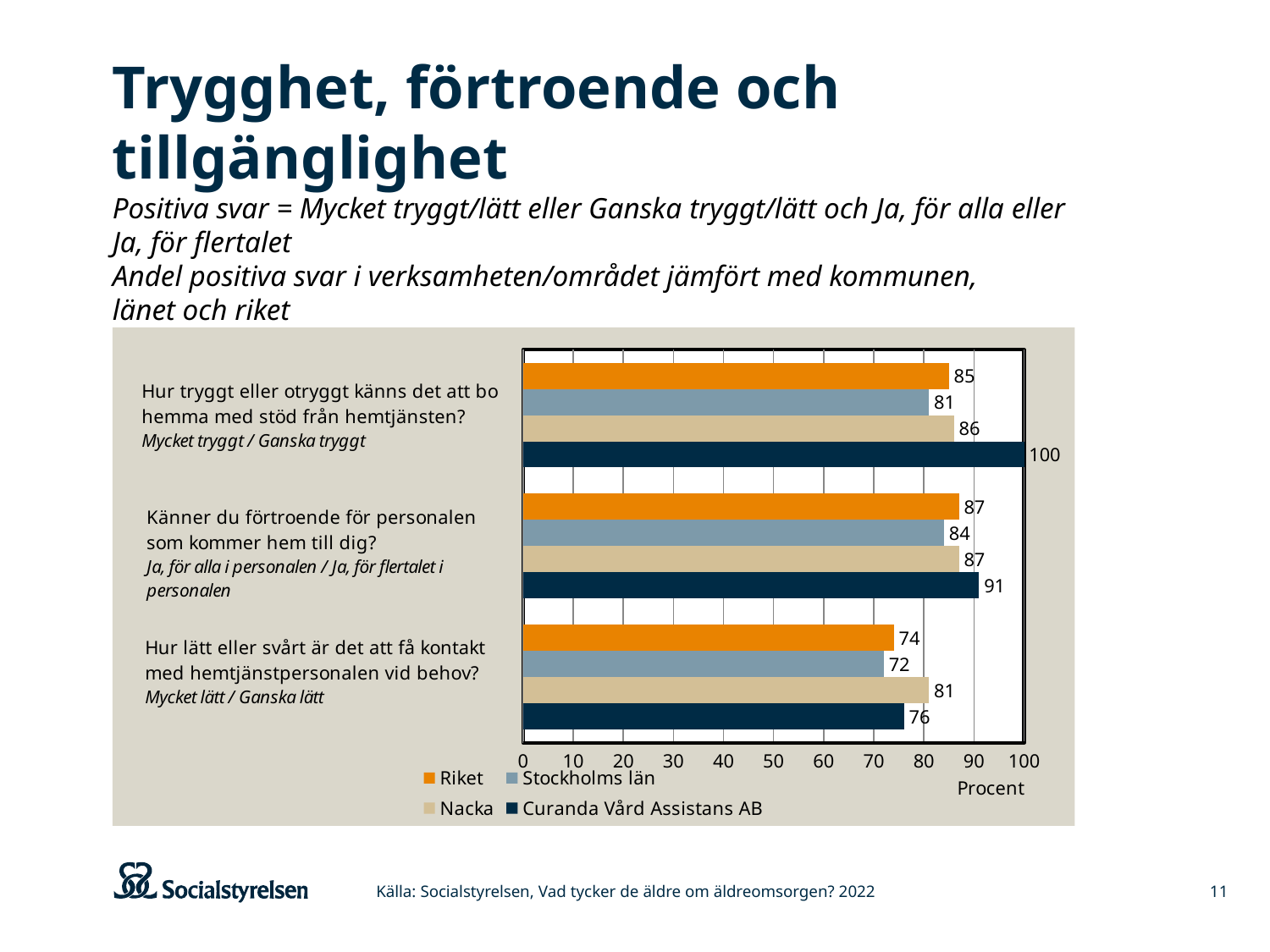
What is the value for Nacka for the question "Hur lätt eller svårt är det att få kontakt med hemtjänstpersonalen vid behov?"? 81 What is the difference between the Curanda Vård Assistans AB value and the Stockholms län value for the question "Känner du förtroende för personalen som kommer hem till dig?"? 7 What is the label on the horizontal axis of the chart? Procent How many question categories are plotted on the chart? 3 What is the difference between the Curanda Vård Assistans AB value and the Riket value for the question "Hur tryggt eller otryggt känns det att bo hemma med stöd från hemtjänsten?"? 15 For the question "Hur lätt eller svårt är det att få kontakt med hemtjänstpersonalen vid behov?", which is larger: the value for Nacka or the value for Curanda Vård Assistans AB? Nacka How many series does the legend list? 4 What is the value for Stockholms län for the question "Känner du förtroende för personalen som kommer hem till dig?"? 84 What is the value for Curanda Vård Assistans AB for the question "Hur tryggt eller otryggt känns det att bo hemma med stöd från hemtjänsten?"? 100 Which series has the highest value for the question "Hur tryggt eller otryggt känns det att bo hemma med stöd från hemtjänsten?"? Curanda Vård Assistans AB Which series has the lowest value for the question "Hur lätt eller svårt är det att få kontakt med hemtjänstpersonalen vid behov?"? Stockholms län What kind of chart is shown on the slide? bar chart